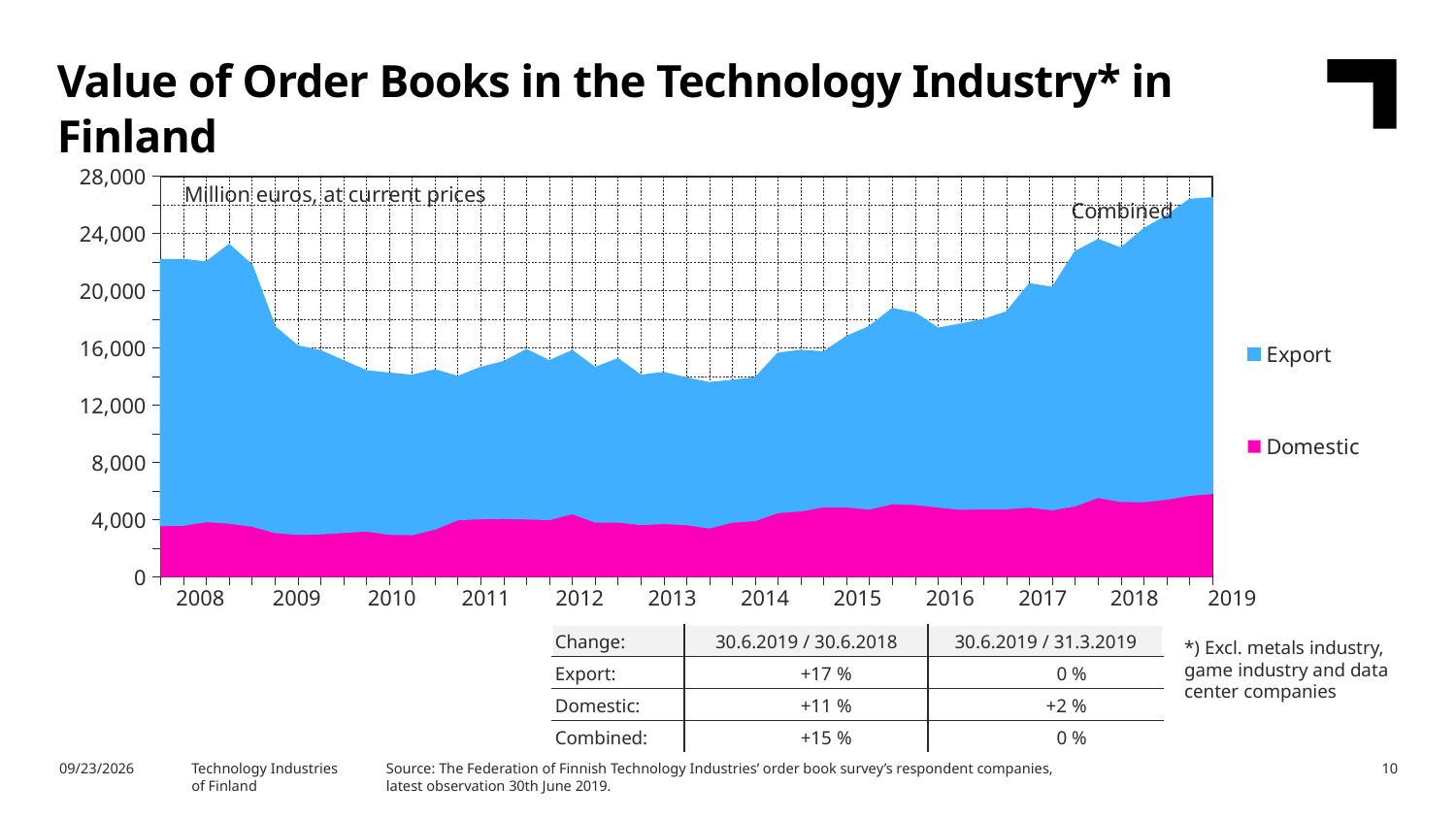
Is the combined value of order books at the end of the series (2019) greater or less than 24,000? greater Is the combined value of order books at the start of 2008 greater or less than 20,000? greater Which two series are listed in the legend? Export and Domestic Is the Domestic value at the end of the series (2019) greater or less than 8,000? less What unit is stated for the values in the chart? Million euros, at current prices Which series is larger in 2019, Export or Domestic? Export Does the combined value of order books rise or fall between 2016 and 2019? rise How many series does the legend list? 2 In which year does the combined value of order books reach its highest level? 2019 What kind of chart is shown on the slide? Stacked area chart How many years are labelled on the x axis? 12